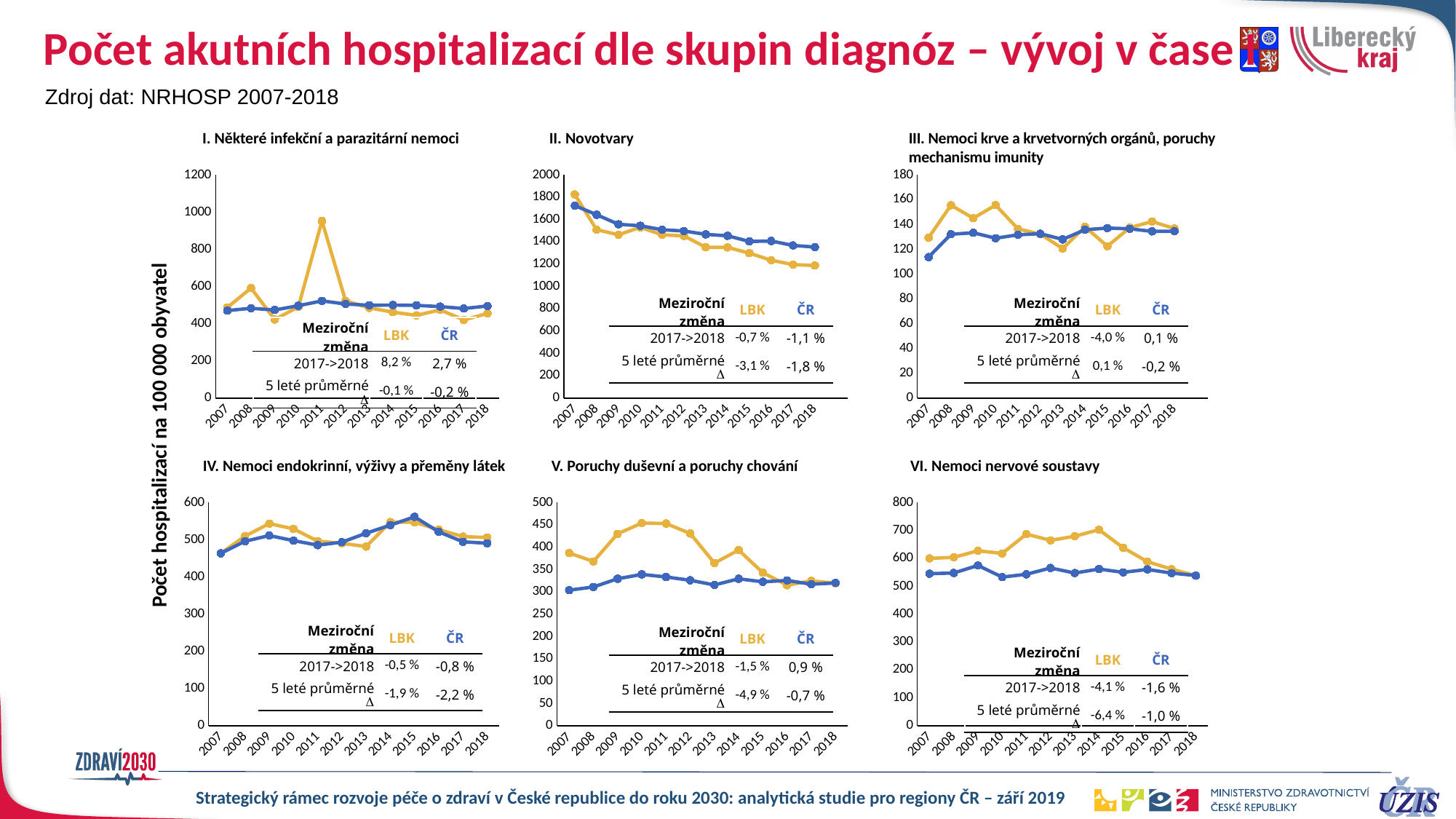
In the chart titled 'I. Některé infekční a parazitární nemoci', is the LBK value for 2011 greater or less than 800? greater In the chart titled 'III. Nemoci krve a krvetvorných orgánů, poruchy mechanismu imunity', what is the 2017->2018 meziroční změna for ČR? 0,1 % In the chart titled 'VI. Nemoci nervové soustavy', what is the 5 leté průměrné Δ for LBK? -6,4 % In the chart titled 'II. Novotvary', what is the 5 leté průměrné Δ for LBK? -3,1 % In the chart titled 'I. Některé infekční a parazitární nemoci', which year has the highest LBK value? 2011 How many series are plotted in the chart titled 'IV. Nemoci endokrinní, výživy a přeměny látek'? 2 What kind of chart is used in the chart titled 'II. Novotvary'? line chart In the chart titled 'II. Novotvary', do the ČR values rise or fall from 2007 to 2018? fall How many years are shown on the x axis of the chart titled 'I. Některé infekční a parazitární nemoci'? 12 In the chart titled 'V. Poruchy duševní a poruchy chování', which series has the larger value in 2010, LBK or ČR? LBK In the chart titled 'II. Novotvary', is the LBK value for 2018 greater or less than 1400? less In the chart titled 'I. Některé infekční a parazitární nemoci', what is the 2017->2018 meziroční změna for LBK? 8,2 %